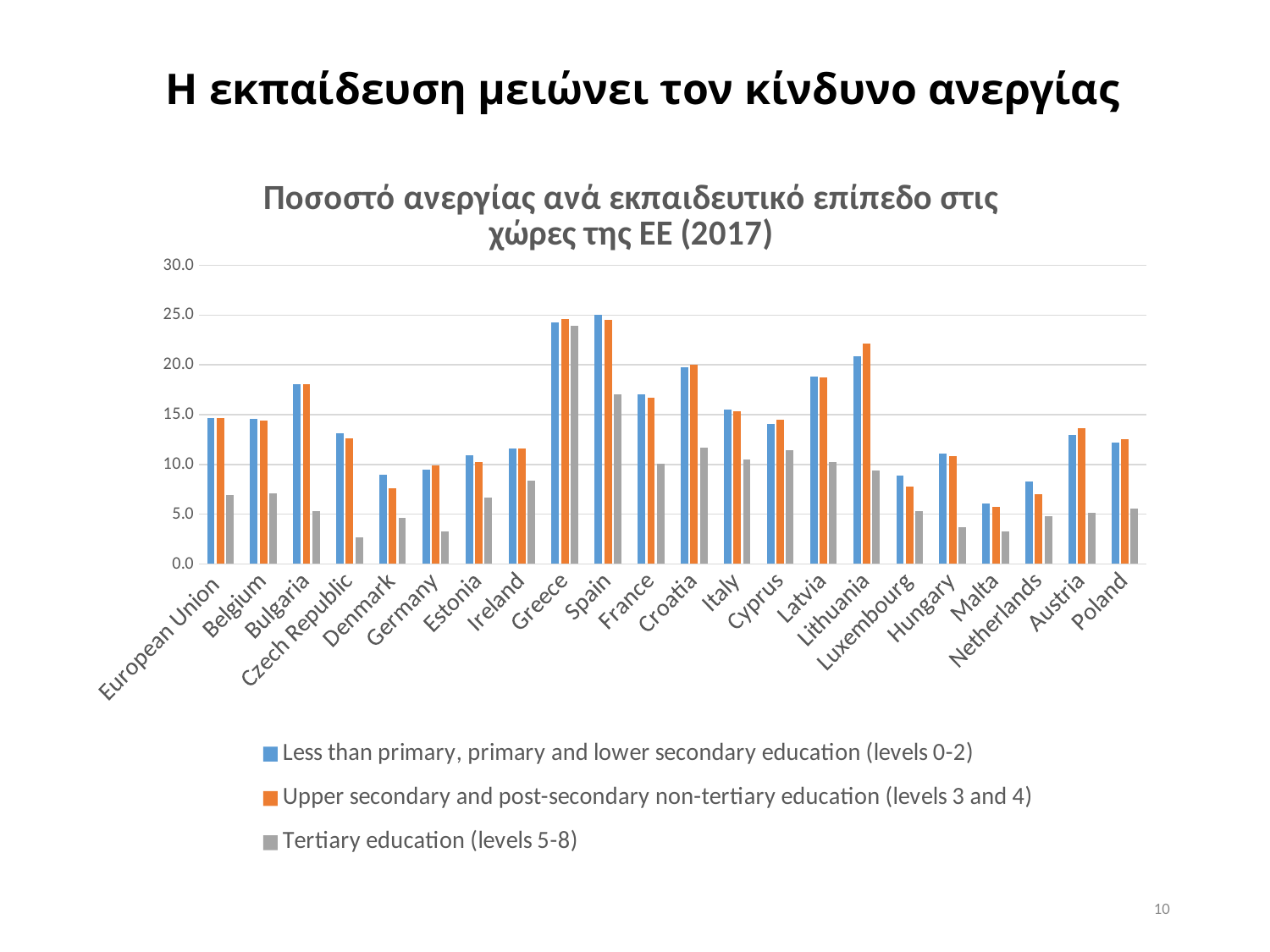
Which category has the highest value for Tertiary education (levels 5-8)? Greece Is the value for Greece in Tertiary education (levels 5-8) greater or less than 20.0? greater Is the value for Czech Republic in Tertiary education (levels 5-8) greater or less than 5.0? less Which is larger for Less than primary, primary and lower secondary education (levels 0-2): Belgium or Bulgaria? Bulgaria Is the value for Denmark in Less than primary, primary and lower secondary education (levels 0-2) greater or less than 10.0? less Which category has the lowest value for Less than primary, primary and lower secondary education (levels 0-2)? Malta Which category has the lowest value for Tertiary education (levels 5-8)? Czech Republic How many countries/categories are shown on the x axis? 22 Which is larger for Tertiary education (levels 5-8): Greece or Spain? Greece How many series does the legend list? 3 What kind of chart is shown on the slide? bar chart